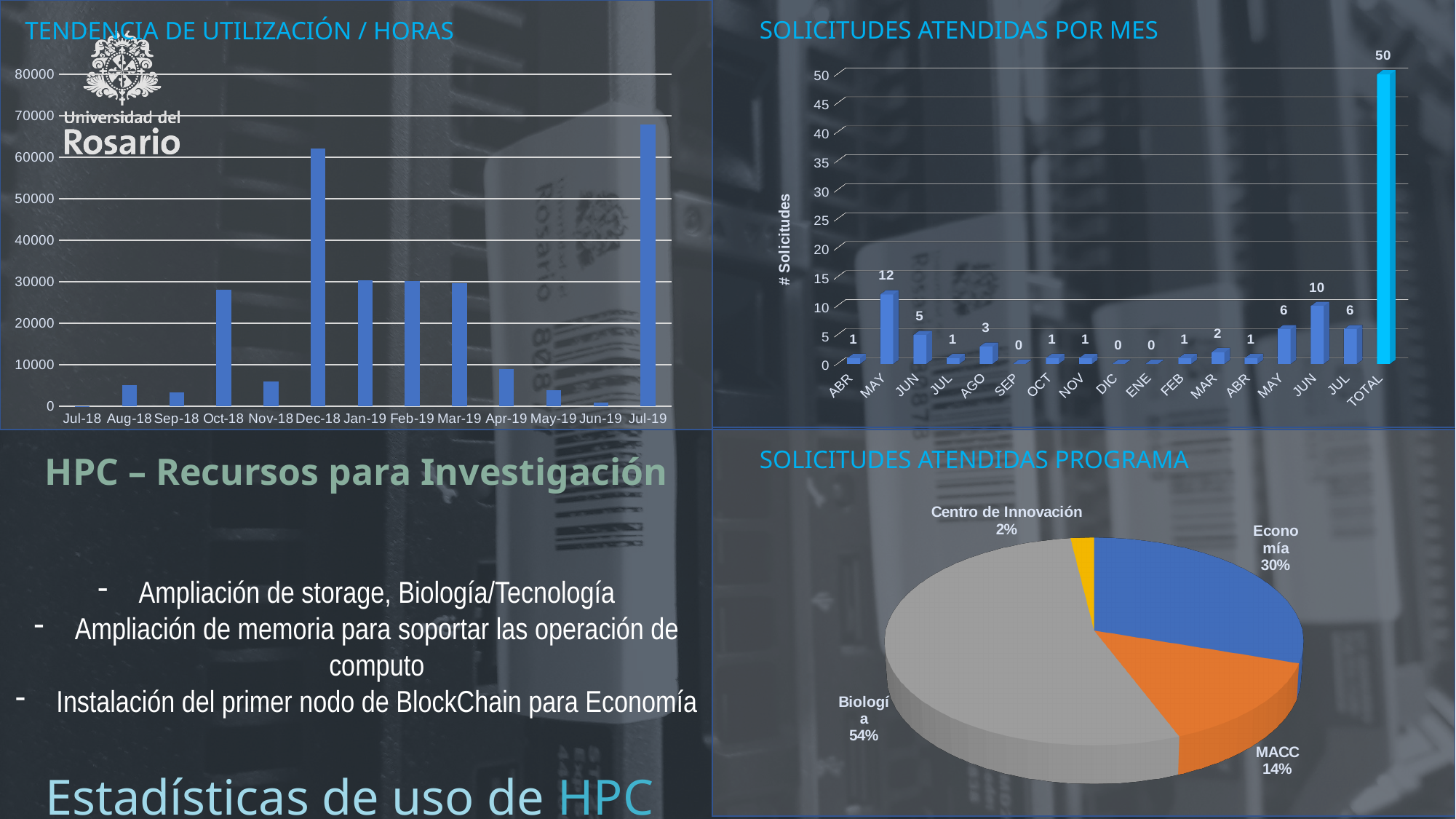
In the 'SOLICITUDES ATENDIDAS POR MES' chart, what is the difference between the second JUN bar (10) and the second MAY bar (6)? 4 In the 'TENDENCIA DE UTILIZACIÓN / HORAS' chart, is the value for Jul-19 greater or less than 60000? greater In the 'SOLICITUDES ATENDIDAS PROGRAMA' pie chart, what share does Biología have? 54% In the 'SOLICITUDES ATENDIDAS POR MES' chart, what is the value for AGO? 3 In the 'TENDENCIA DE UTILIZACIÓN / HORAS' chart, which month has the highest value? Jul-19 What kind of chart is 'TENDENCIA DE UTILIZACIÓN / HORAS'? bar chart In the 'SOLICITUDES ATENDIDAS PROGRAMA' pie chart, which program has the smallest slice? Centro de Innovación In the 'SOLICITUDES ATENDIDAS POR MES' chart, how many categories are shown on the x axis, including TOTAL? 17 In the 'SOLICITUDES ATENDIDAS POR MES' chart, what is the value for the first MAY bar (the second category from the left)? 12 In the 'SOLICITUDES ATENDIDAS POR MES' chart, what is the value for TOTAL? 50 In the 'SOLICITUDES ATENDIDAS PROGRAMA' pie chart, how many slices are there? 4 In the 'SOLICITUDES ATENDIDAS POR MES' chart, excluding TOTAL, which month has the highest value? MAY (the first one, 12)